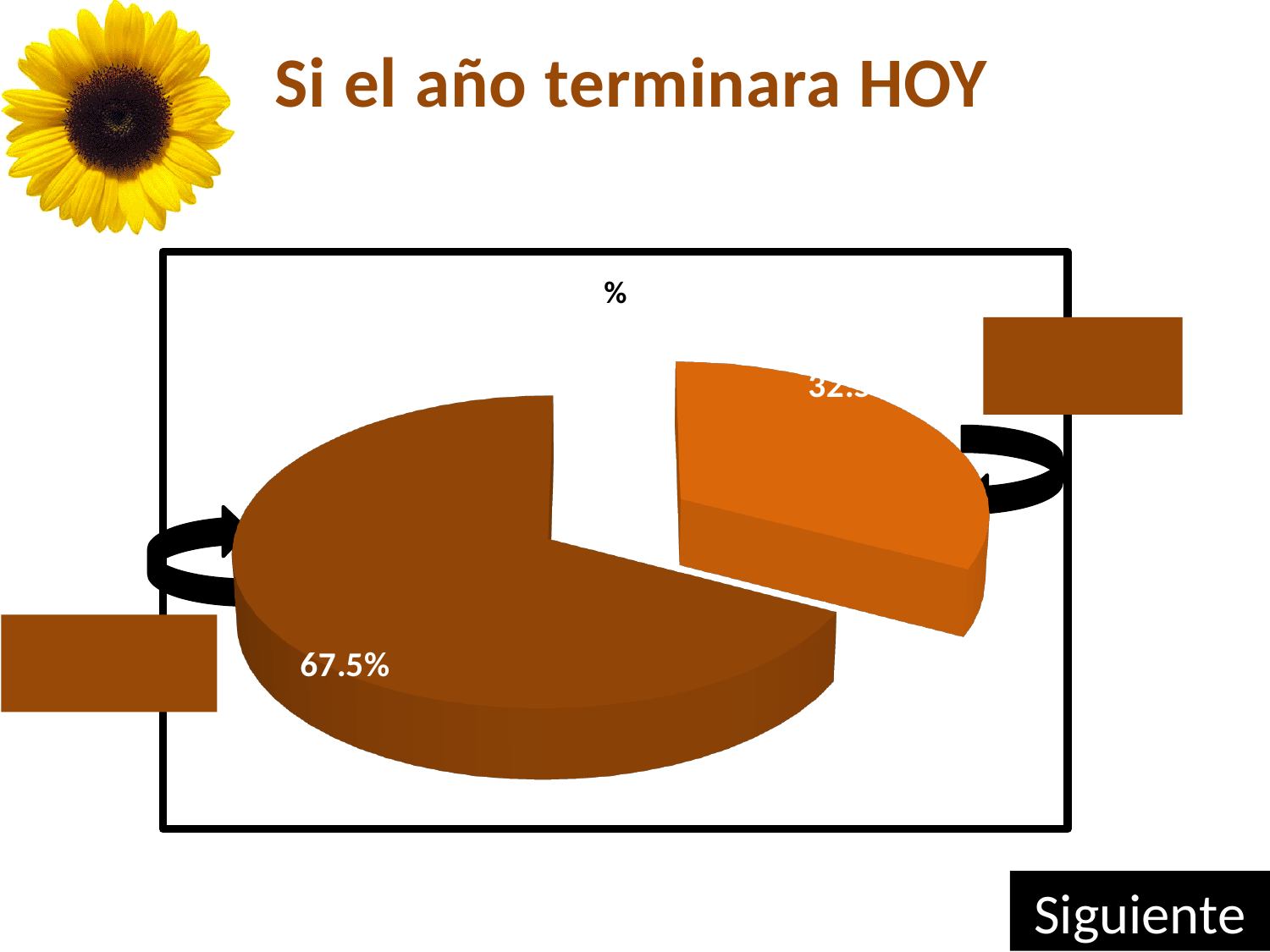
What colour is the slice labelled 67.5%? dark brown How many slices does the pie chart have? 2 What share of the pie does the dark brown slice represent? 67.5% Is the value of the orange slice greater or less than 50%? less What share of the pie does the orange slice represent? 32.5% What is the title of the chart? % What kind of chart is shown on the slide? pie chart Which slice is larger, the dark brown slice or the orange slice? the dark brown slice What is the difference between the two slices of the pie chart? 35% What percentage is shown on the largest slice of the pie chart? 67.5% Is the value of the dark brown slice greater or less than 50%? greater